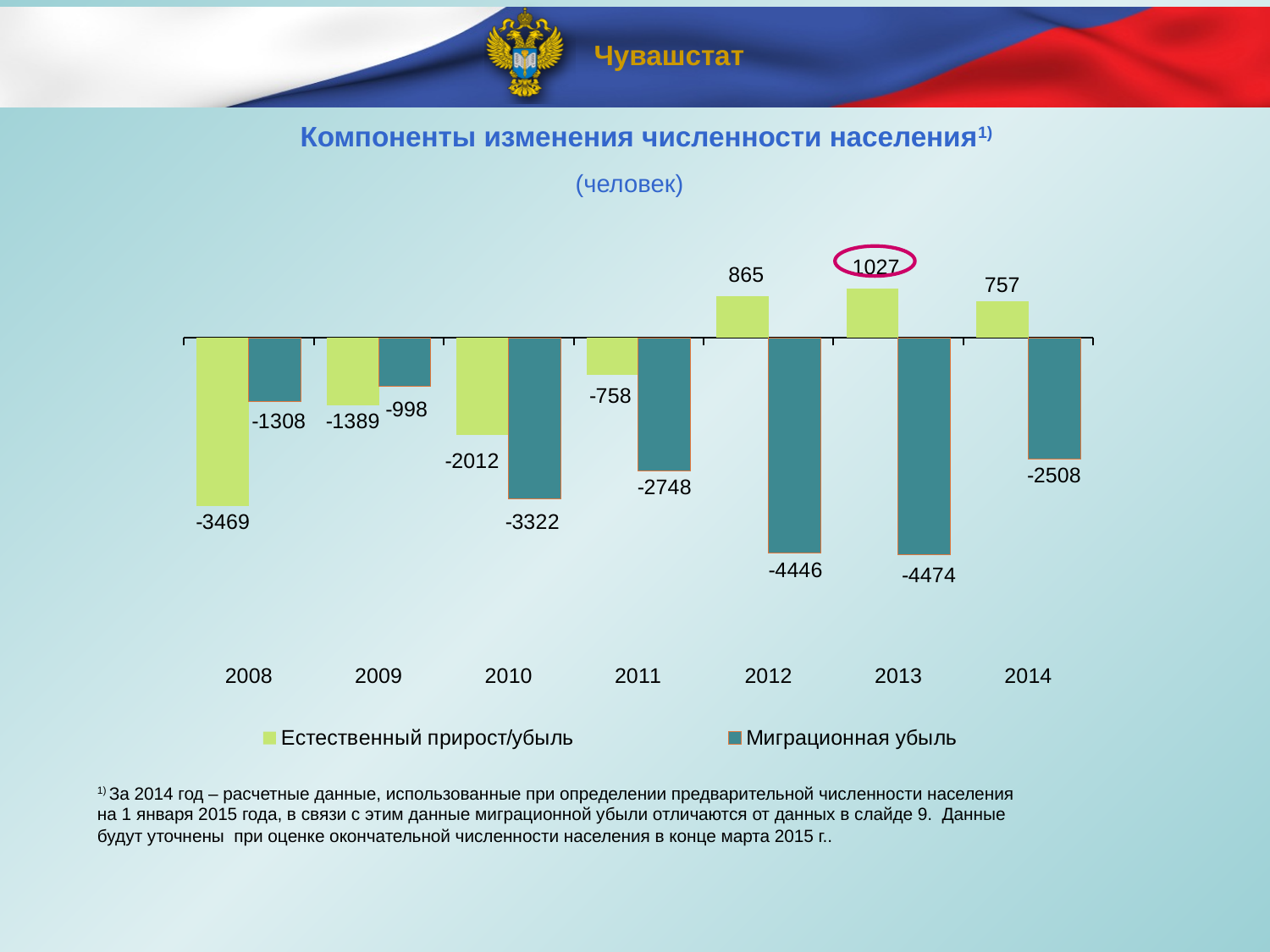
What is the value of Миграционная убыль for 2012? -4446 What unit is given under the chart title? человек Which is larger, Миграционная убыль in 2009 or in 2011? 2009 How many years are shown on the x axis? 7 What is the difference between Естественный прирост/убыль in 2012 and 2014? 108 What kind of chart is shown on the slide? Bar chart What is the value of Миграционная убыль for 2014? -2508 In which year is Миграционная убыль lowest (most negative)? 2013 What is the value of Естественный прирост/убыль for 2013? 1027 In which year is Естественный прирост/убыль highest? 2013 How many series does the legend list? 2 What is the value of Естественный прирост/убыль for 2008? -3469